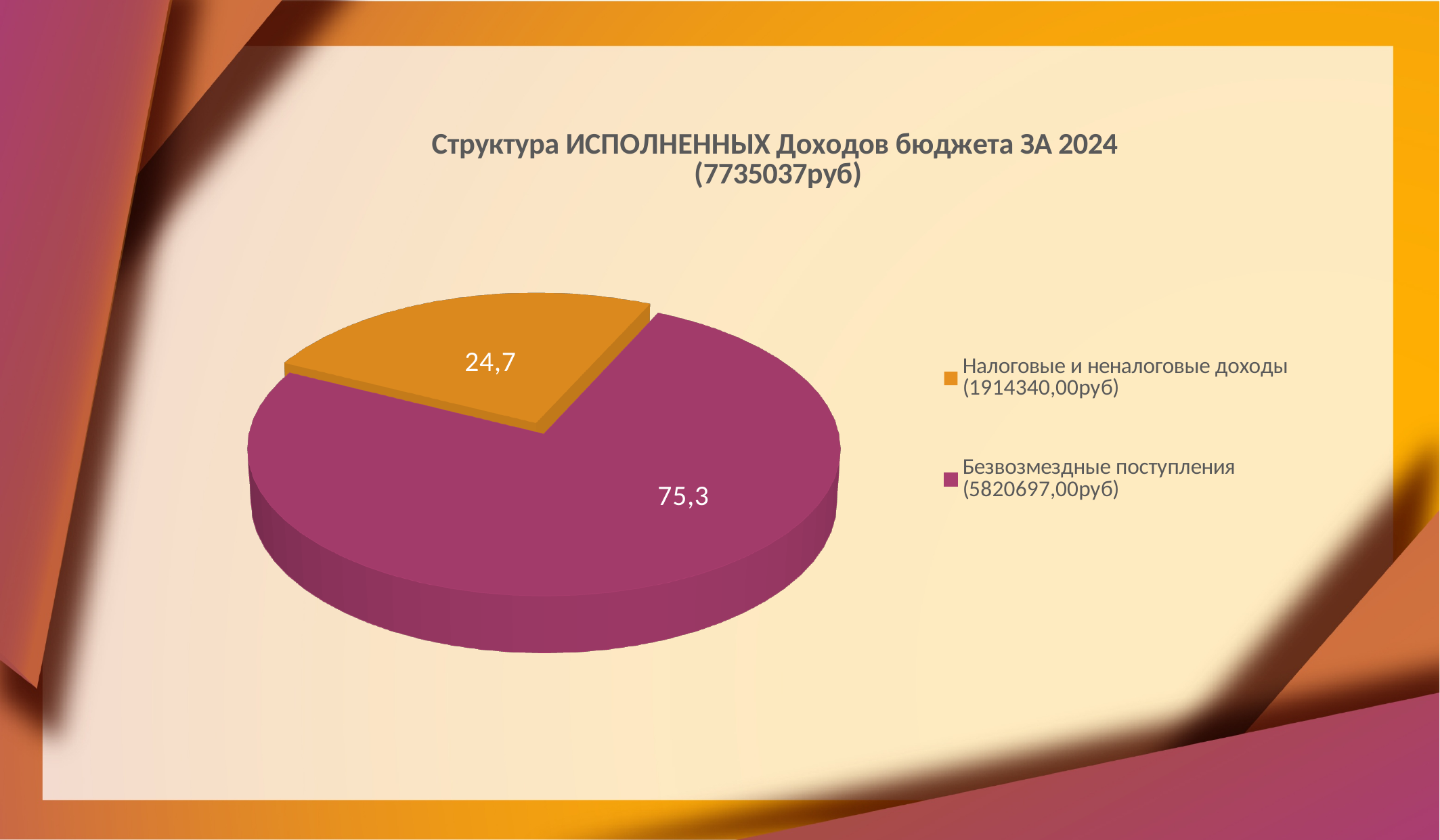
What is the difference between the data labels for Безвозмездные поступления and Налоговые и неналоговые доходы? 50,6 Which category has the largest slice of the pie? Безвозмездные поступления How many entries does the legend list? 2 What amount in rubles is shown in the legend for Налоговые и неналоговые доходы? 1914340,00руб What is the data label on the slice for Безвозмездные поступления? 75,3 What total amount is shown in parentheses in the chart title? 7735037руб Which slice is larger: Налоговые и неналоговые доходы or Безвозмездные поступления? Безвозмездные поступления What is the data label on the slice for Налоговые и неналоговые доходы? 24,7 How many slices does the pie chart have? 2 What kind of chart is shown on the slide? Pie chart Which category has the smallest slice of the pie? Налоговые и неналоговые доходы